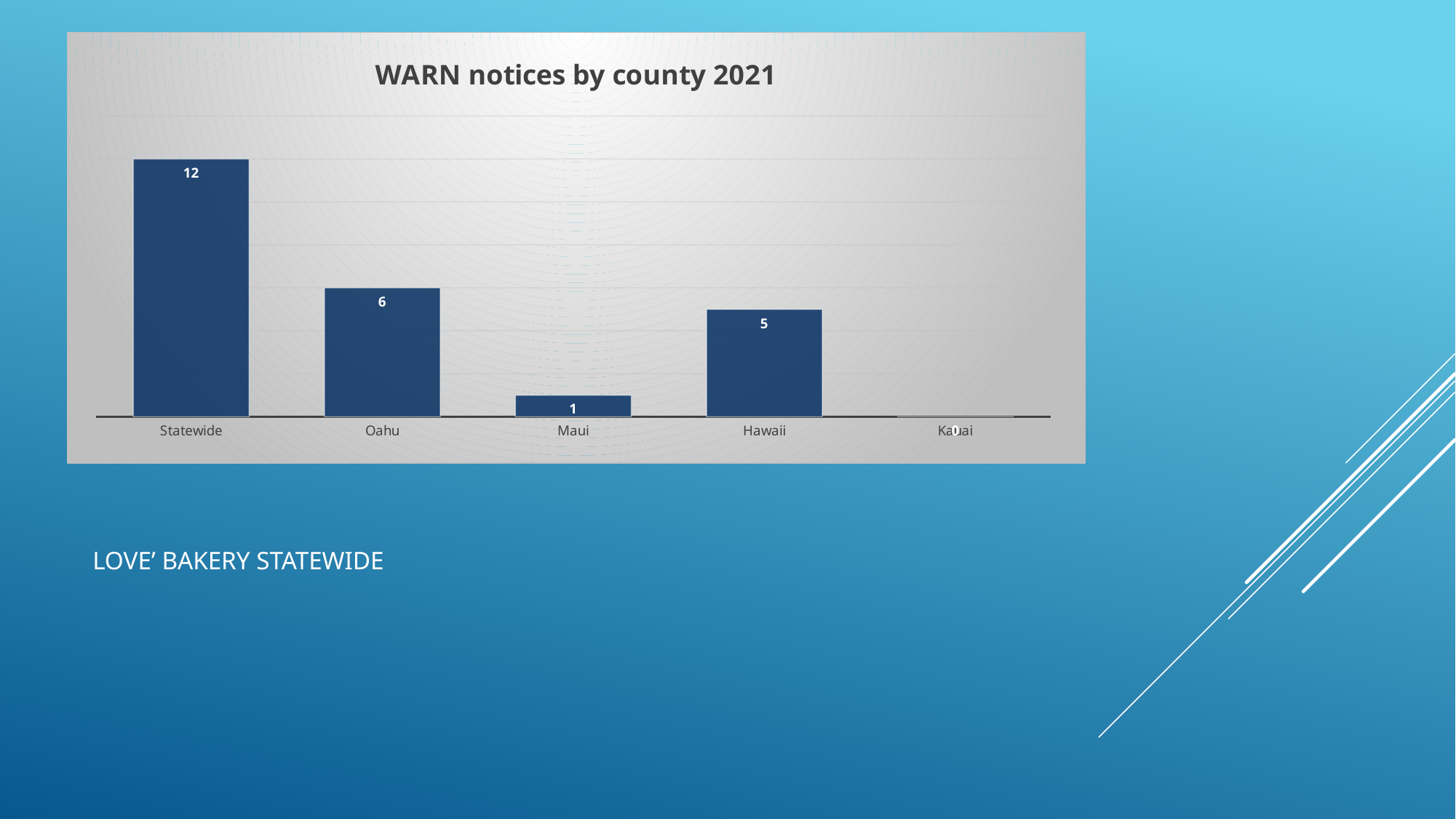
What is the difference between the values for Statewide and Maui? 11 What is the value for Kauai? 0 What is the difference between the values for Oahu and Hawaii? 1 What is the value for Oahu? 6 Which is larger, the value for Oahu or the value for Maui? Oahu Which category has the lowest value? Kauai What is the value for Statewide? 12 What kind of chart is shown on the slide? Bar chart What is the value for Hawaii? 5 How many categories are shown on the x axis? 5 What is the value for Maui? 1 Which category has the highest value? Statewide